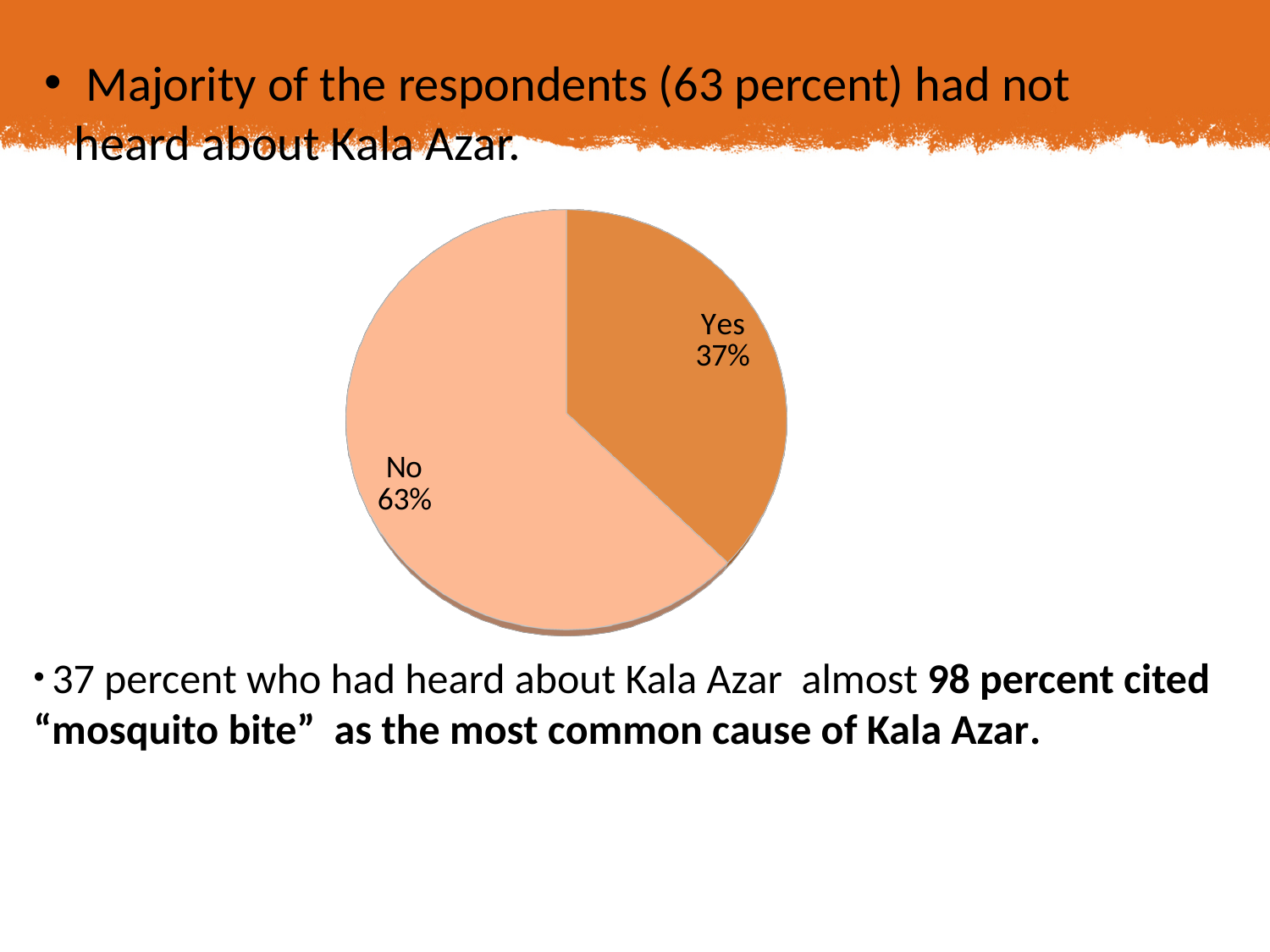
Which slice is shown in the darker orange colour? Yes Which is larger, the "Yes" slice or the "No" slice? No Which slice of the pie is the smallest? Yes Which slice of the pie is the largest? No What share of the pie does the "No" slice represent? 63% What kind of chart is shown on the slide? pie chart What is the difference in percentage points between the "No" and "Yes" slices? 26 What are the labels of the two slices in the pie chart? Yes and No How many slices does the pie chart have? 2 What is the value shown for the "No" category? 63% What share of the pie does the "Yes" slice represent? 37% What is the value shown for the "Yes" category? 37%